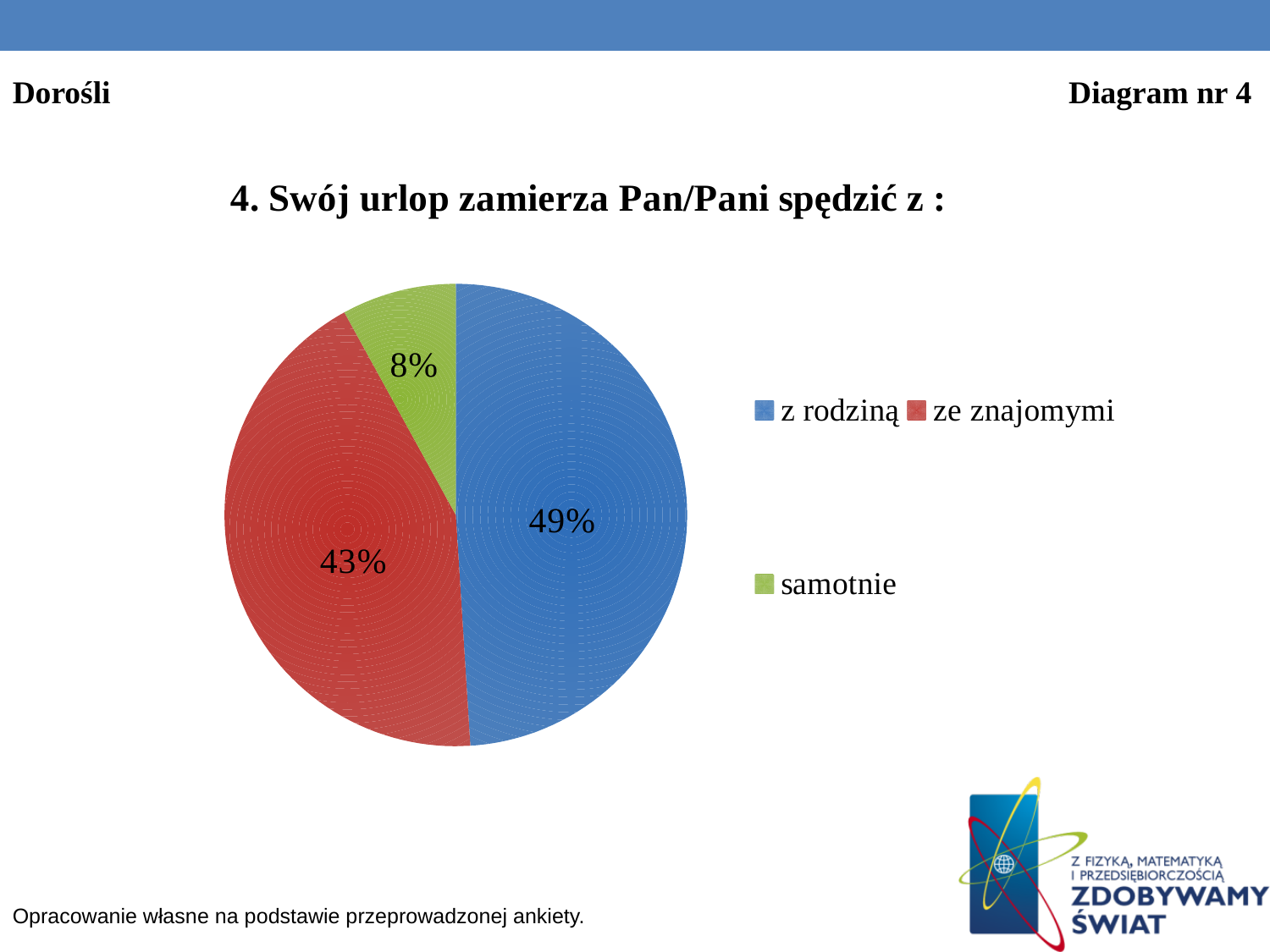
Which is larger: the share for 'z rodziną' or the share for 'samotnie'? z rodziną What is the title of the chart? 4. Swój urlop zamierza Pan/Pani spędzić z : What is the difference in percentage points between 'z rodziną' and 'ze znajomymi'? 6 How many categories does the pie chart have? 3 What kind of chart is shown on the slide? pie chart Which colour represents 'ze znajomymi' in the pie chart? red Which category has the largest share of the pie? z rodziną What percentage of respondents plan to spend their holiday 'ze znajomymi'? 43% What is the difference in percentage points between 'ze znajomymi' and 'samotnie'? 35 What percentage of respondents plan to spend their holiday 'samotnie'? 8% What percentage of respondents plan to spend their holiday 'z rodziną'? 49% Which category has the smallest share of the pie? samotnie